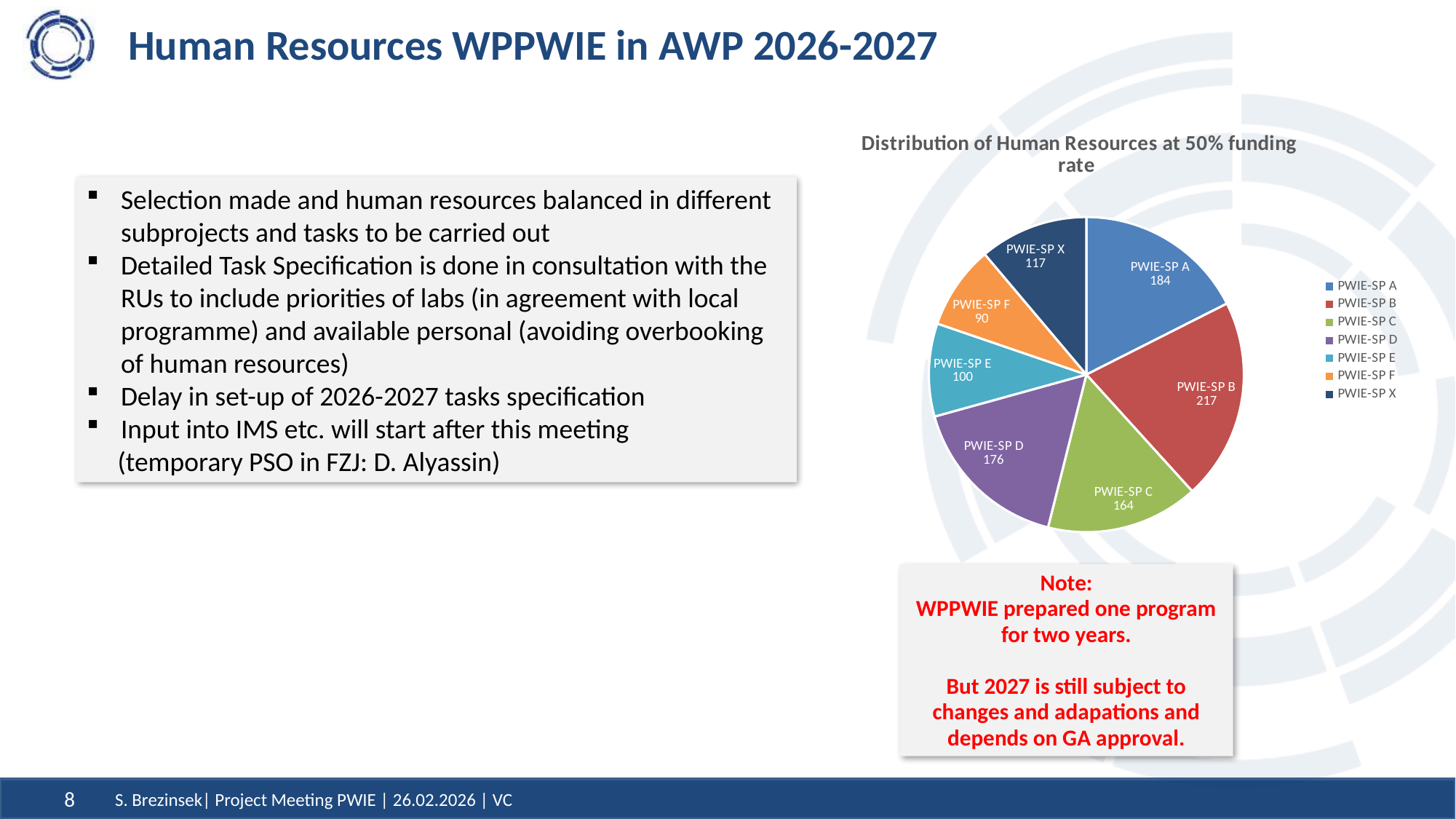
What is the difference between the values for PWIE-SP B and PWIE-SP A? 33 What is the difference between the values for PWIE-SP X and PWIE-SP F? 27 What is the title of the pie chart? Distribution of Human Resources at 50% funding rate Which subproject has the largest slice of the pie chart? PWIE-SP B Which is larger, the value for PWIE-SP D or PWIE-SP C? PWIE-SP D What is the value for PWIE-SP X in the pie chart? 117 What is the value for PWIE-SP B in the pie chart? 217 How many entries does the legend of the pie chart list? 7 How many slices does the pie chart have? 7 What is the value for PWIE-SP E in the pie chart? 100 Which subproject has the smallest slice of the pie chart? PWIE-SP F What kind of chart is shown on the slide? pie chart